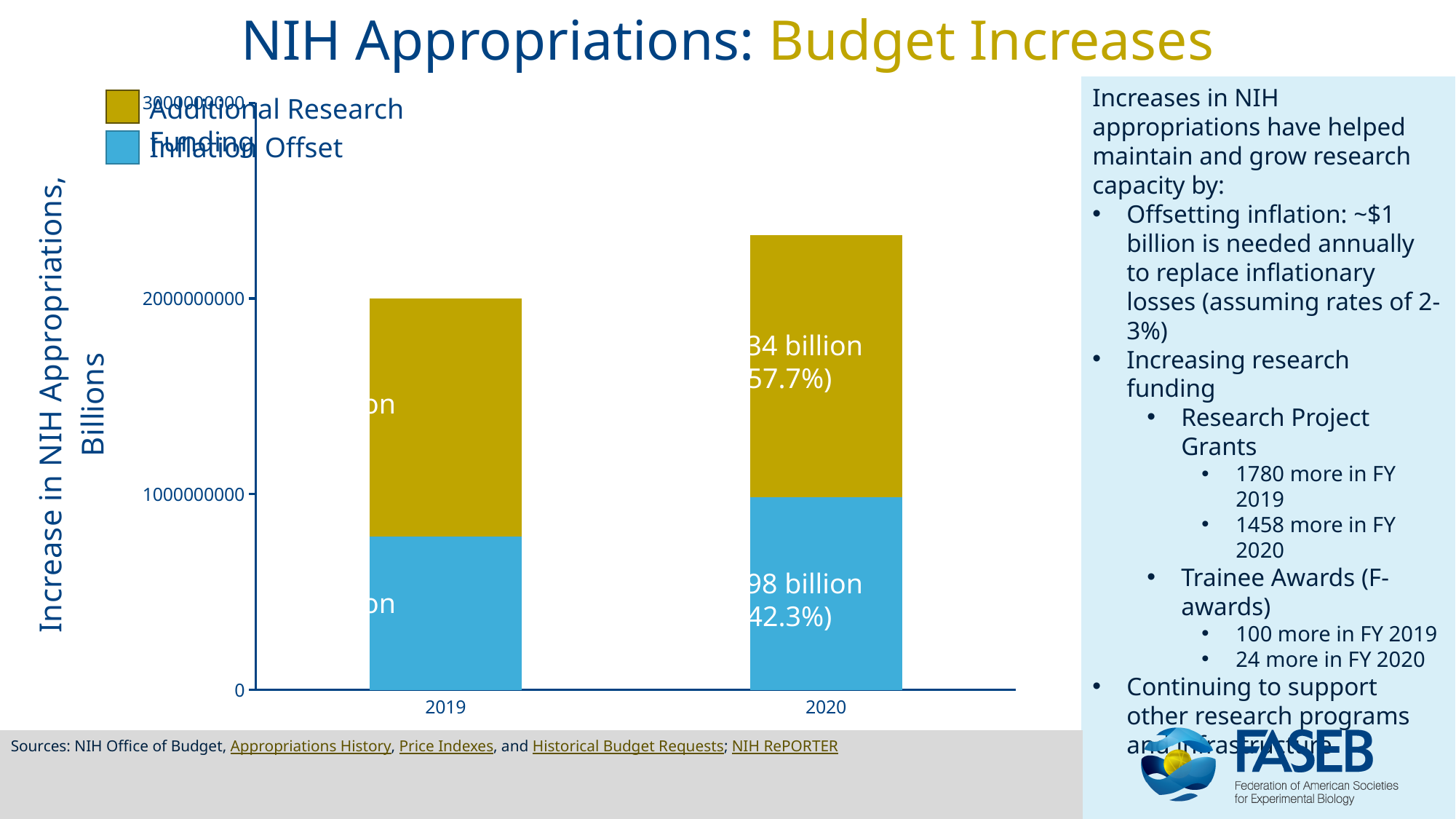
How many series does the chart legend list? 2 How many years are shown on the x axis of the chart? 2 Is the Inflation Offset segment for 2019 greater or less than 1000000000? less Does the total increase in NIH appropriations rise or fall from 2019 to 2020? Rise In 2020, which segment is larger, Additional Research Funding or Inflation Offset? Additional Research Funding What kind of chart is shown on the slide? Stacked bar chart Which year has the taller stacked bar, 2019 or 2020? 2020 What is the title of the chart's y axis? Increase in NIH Appropriations, Billions Is the total height of the 2020 bar greater or less than 2000000000? greater Which series is shown in blue in the chart? Inflation Offset What percentage of the 2020 bar is labelled as Inflation Offset? 42.3% What percentage of the 2020 bar is labelled as Additional Research Funding? 57.7%